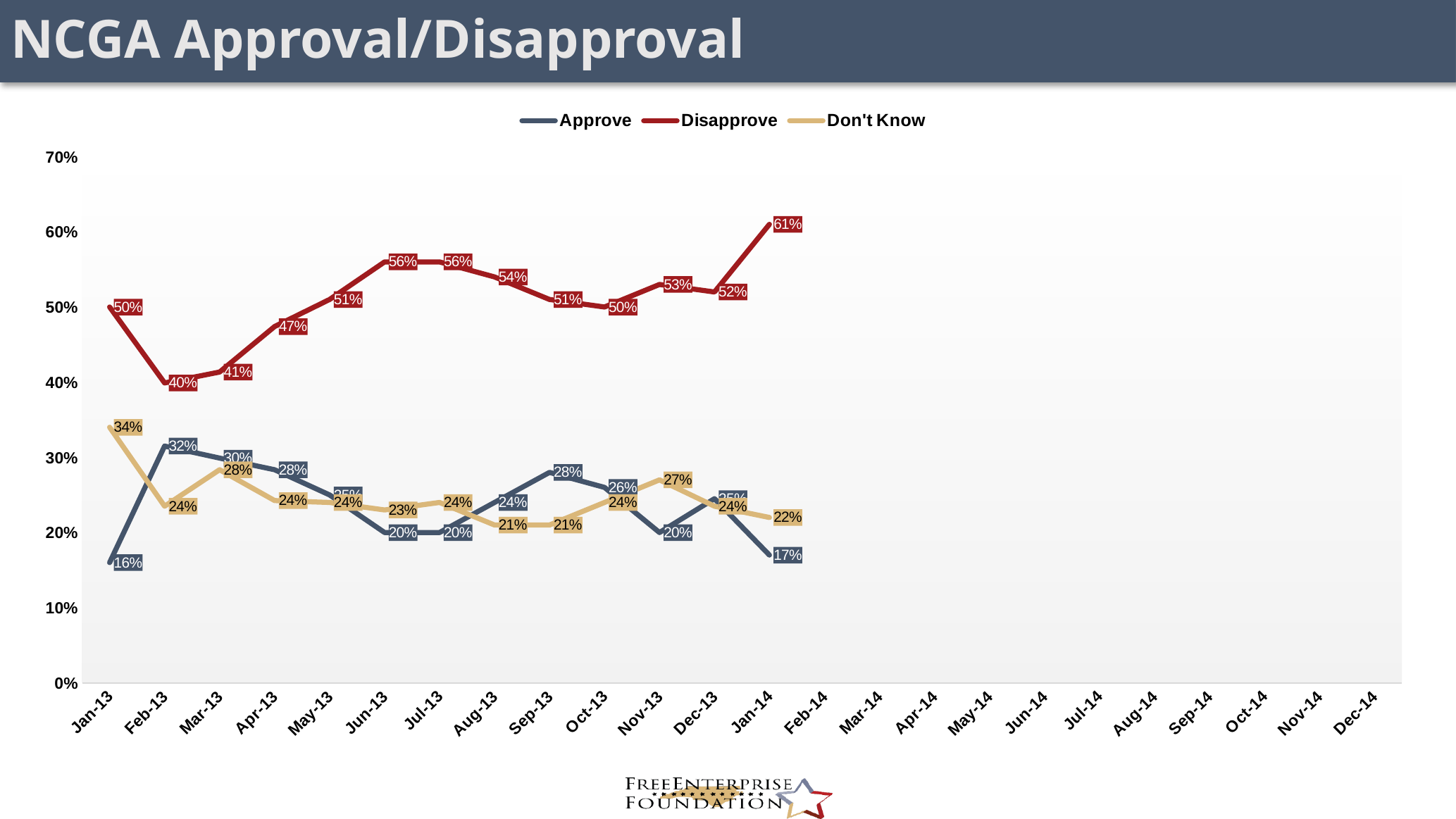
How many series does the legend list? 3 In which month is the Disapprove value highest? Jan-14 What is the Don't Know value for Nov-13? 27% What is the Approve value for Jan-13? 16% Is the Disapprove value for Jun-13 greater or less than 50%? greater What is the Disapprove value for Jan-14? 61% What kind of chart is shown on the slide? line chart In Feb-13, which is larger: Approve or Don't Know? Approve Does the Disapprove line rise or fall from Feb-13 to Jun-13? rise What is the difference between the Disapprove and Approve values in Jan-14? 44 percentage points In which month is the Disapprove value lowest? Feb-13 How many months have data points plotted on the chart? 13